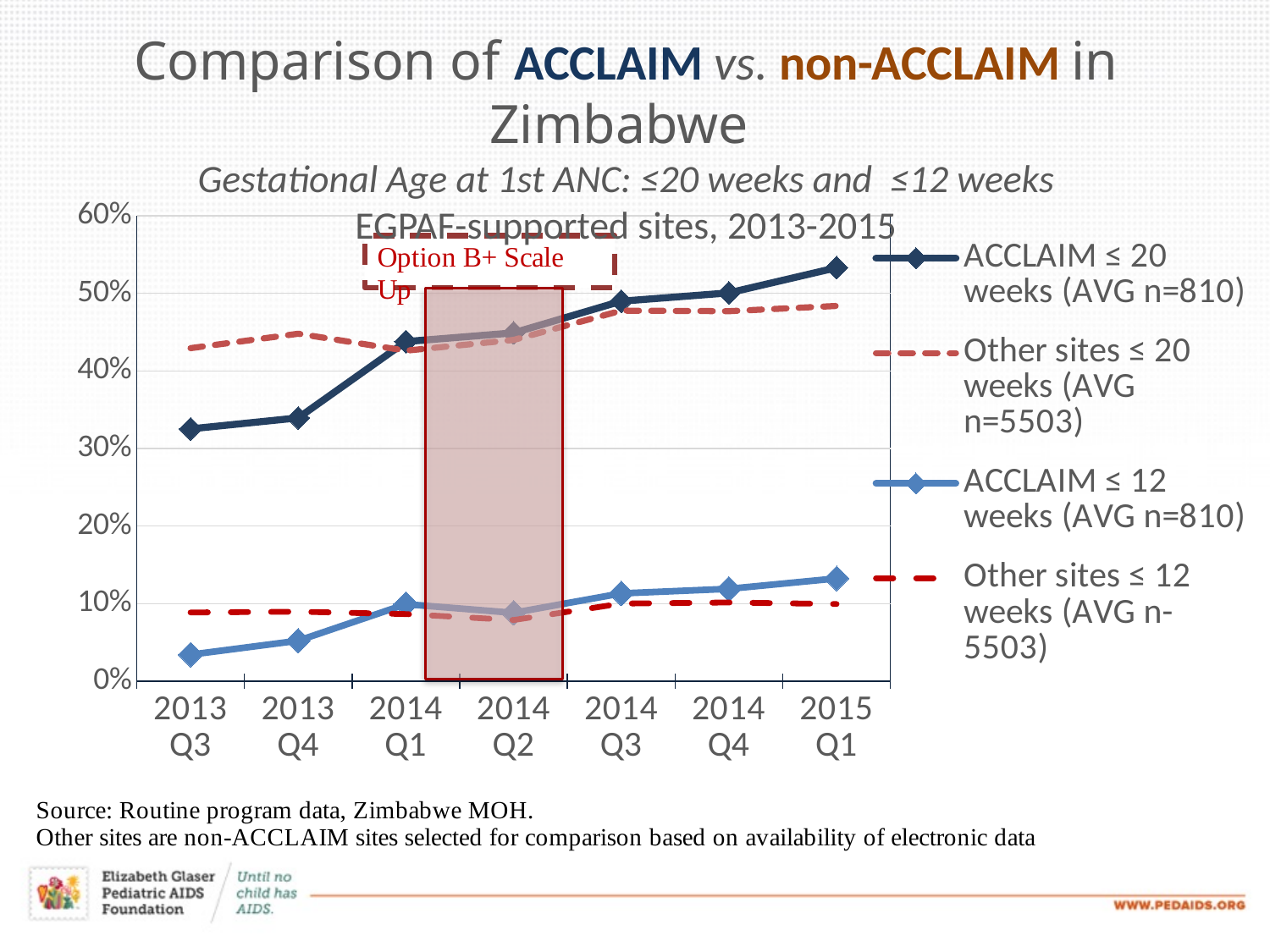
Is the value for ACCLAIM ≤ 20 weeks in 2013 Q3 greater or less than 40%? less How many series does the legend list? 4 Is the value for ACCLAIM ≤ 12 weeks in 2013 Q3 greater or less than 10%? less How many quarters are plotted along the x axis? 7 Does the ACCLAIM ≤ 20 weeks series rise or fall from 2013 Q3 to 2015 Q1? Rise Is the value for Other sites ≤ 20 weeks in 2013 Q3 greater or less than 40%? greater In which quarter is the ACCLAIM ≤ 20 weeks series at its highest? 2015 Q1 What label is shown on the highlighted box over 2014 Q2? Option B+ Scale Up In 2013 Q3, which is higher: ACCLAIM ≤ 20 weeks or Other sites ≤ 20 weeks? Other sites ≤ 20 weeks In which quarter is the ACCLAIM ≤ 12 weeks series at its lowest? 2013 Q3 What kind of chart is shown on the slide? Line chart